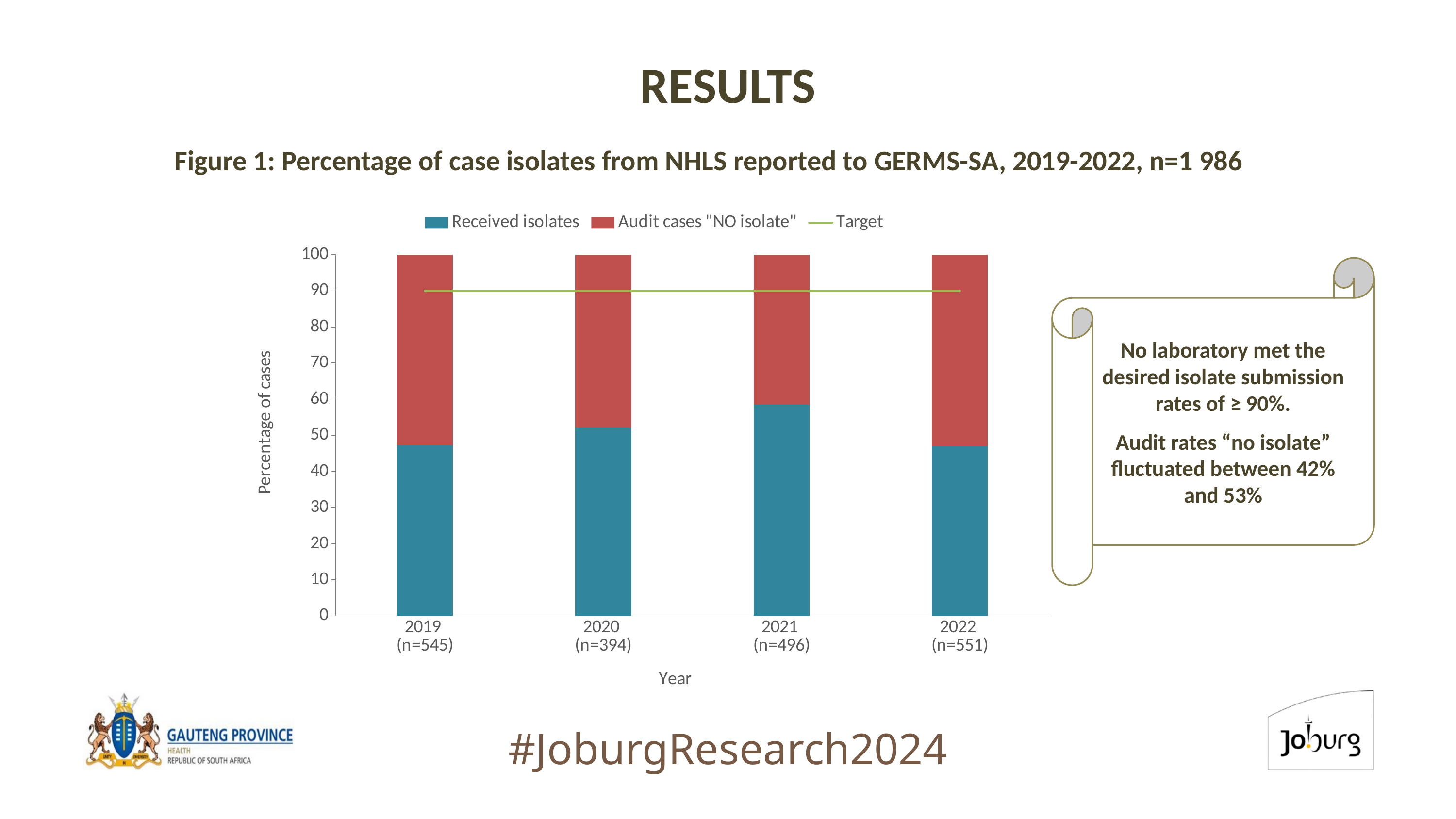
What value does the Target line sit at on the y axis? 90 Which year has the highest percentage of Received isolates? 2021 Is the Received isolates value for 2021 greater or less than 50? greater What is the label of the y axis? Percentage of cases How many entries does the chart legend list? 3 Which legend entry is shown in red? Audit cases "NO isolate" How many years are shown on the x axis of the chart? 4 Which year has a larger Received isolates percentage, 2020 or 2021? 2021 What is the n value shown under the 2020 category label? n=394 Is the Received isolates value for 2019 greater or less than 50? less What is the total height of the stacked bar for 2019? 100 What kind of chart is shown on the slide? Stacked bar chart